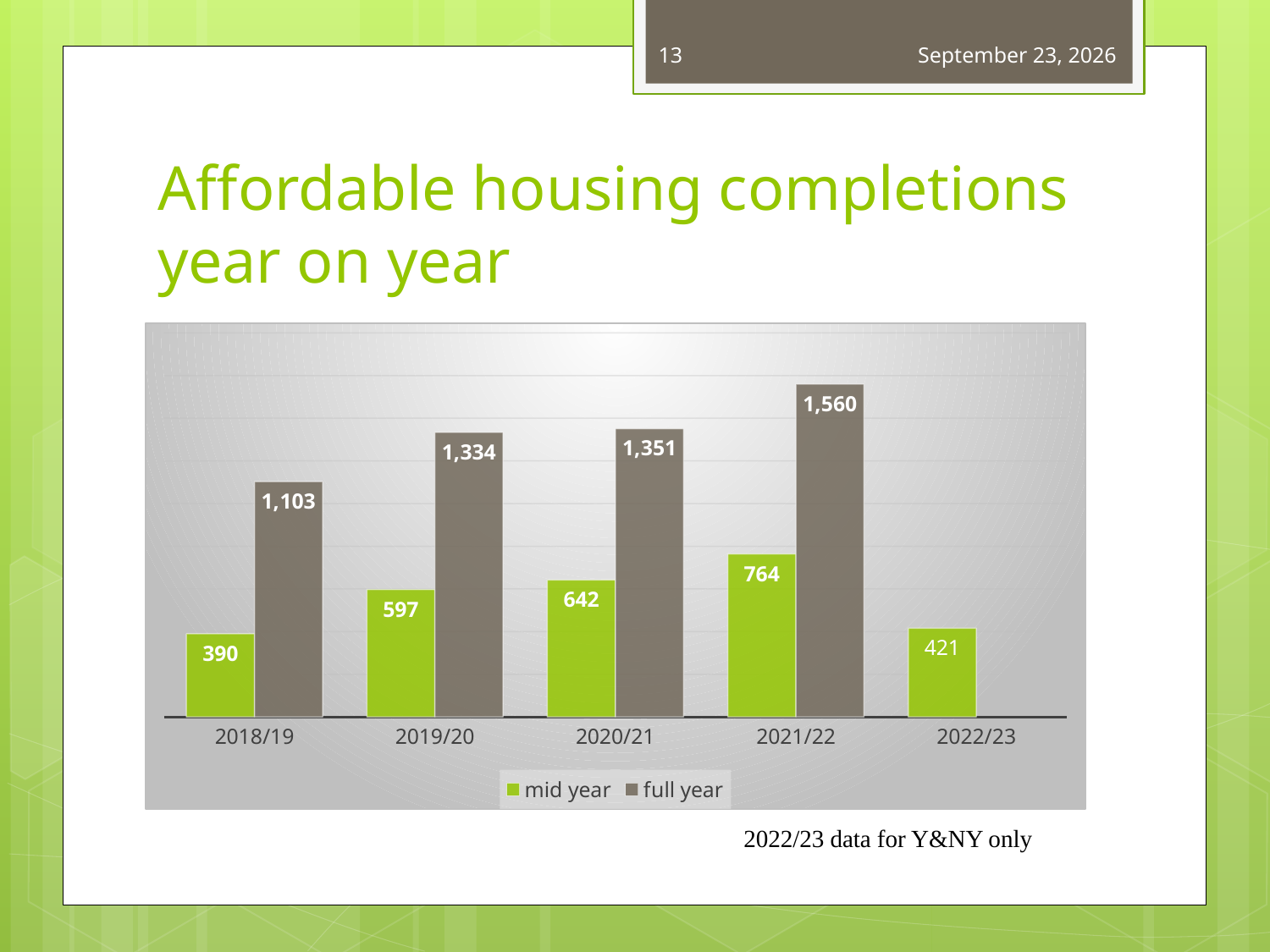
What is the difference between the full year and mid year values for 2020/21? 709 Which is larger, the full year value for 2019/20 or the full year value for 2020/21? 2020/21 What is the full year value for 2021/22? 1,560 How many series does the legend list? 2 How many years are shown on the x axis? 5 Which year has the lowest mid year value? 2018/19 Do the full year values rise or fall from 2018/19 to 2021/22? rise Which series is shown in green in the legend? mid year What is the mid year value for 2022/23? 421 What is the mid year value for 2019/20? 597 Which year has the highest full year value? 2021/22 What kind of chart is shown on the slide? bar chart